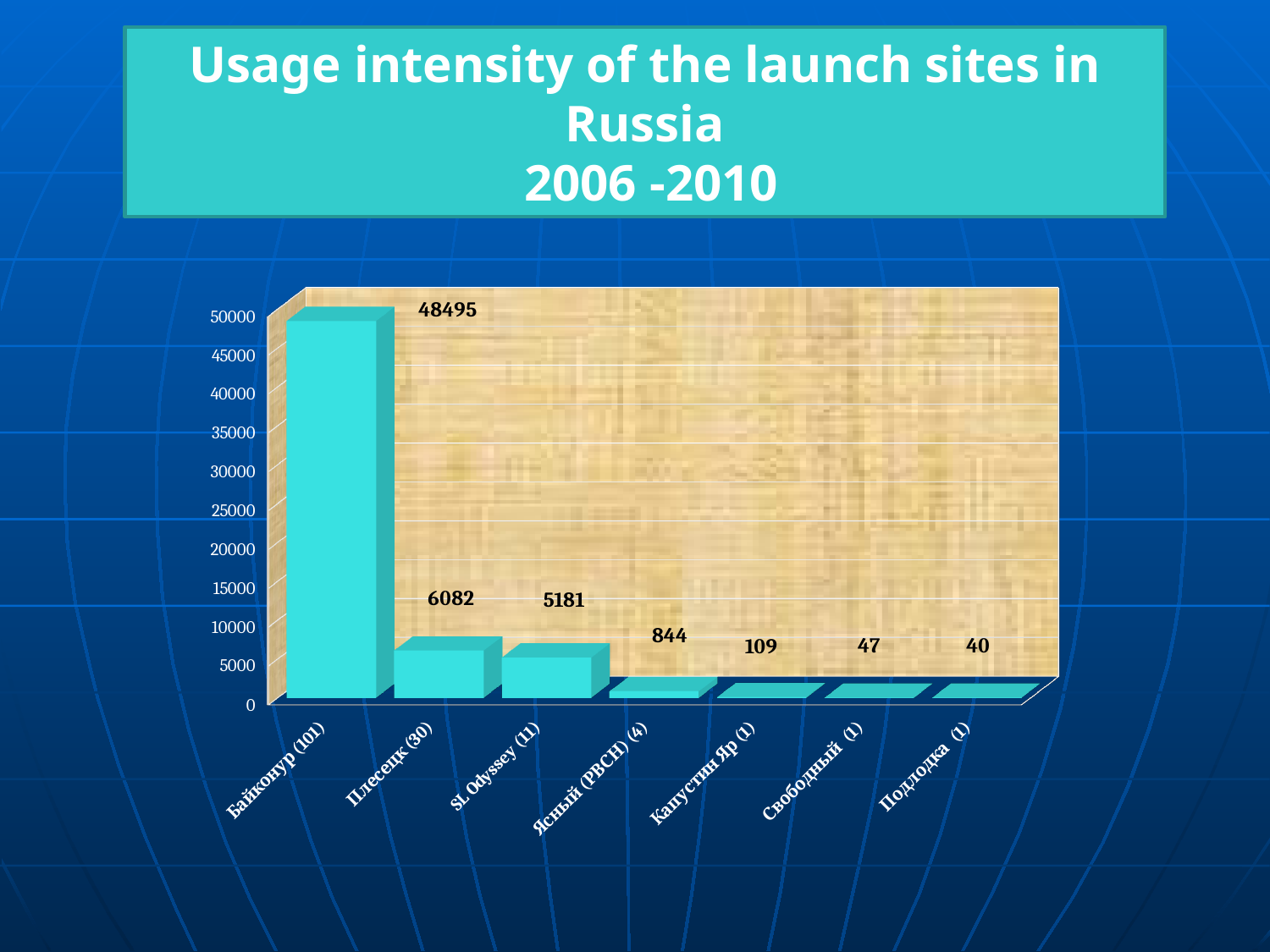
What is the value for SL Odyssey (11)? 5181 Do the values rise or fall from left to right along the x axis? Fall Which launch site has the highest value? Байконур (101) What is the value for Ясный (РВСН) (4)? 844 How many launch sites are shown on the chart? 7 What kind of chart is shown on the slide? Bar chart What is the value for Подлодка (1)? 40 Which launch site has the lowest value? Подлодка (1) What is the difference between the values for Плесецк (30) and SL Odyssey (11)? 901 Which is larger, the value for Капустин Яр (1) or the value for Свободный (1)? Капустин Яр (1) What is the value for Плесецк (30)? 6082 What is the value for Байконур (101)? 48495